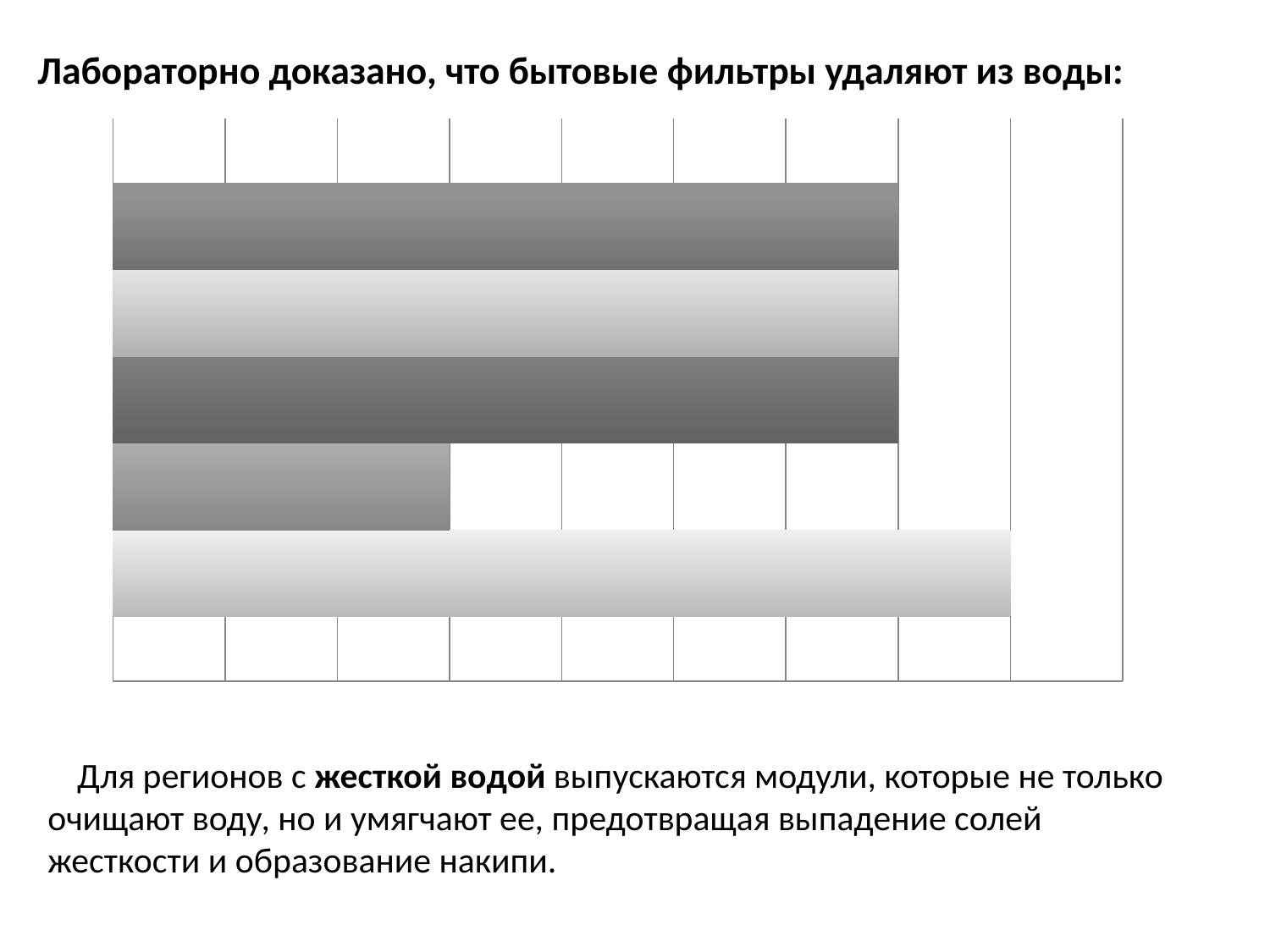
What is the title text above the chart? Лабораторно доказано, что бытовые фильтры удаляют из воды: Which is longer: the fourth bar from the top or the fifth (bottom) bar? the fifth (bottom) bar What kind of chart is shown on the slide? bar chart Are the bars in the chart oriented horizontally or vertically? horizontally How many bars does the chart contain? 5 Which is longer: the first bar from the top or the fourth bar from the top? the first bar Which bar in the chart is the longest, counting from the top? the fifth (bottom) bar Which bar in the chart is the shortest, counting from the top? the fourth bar